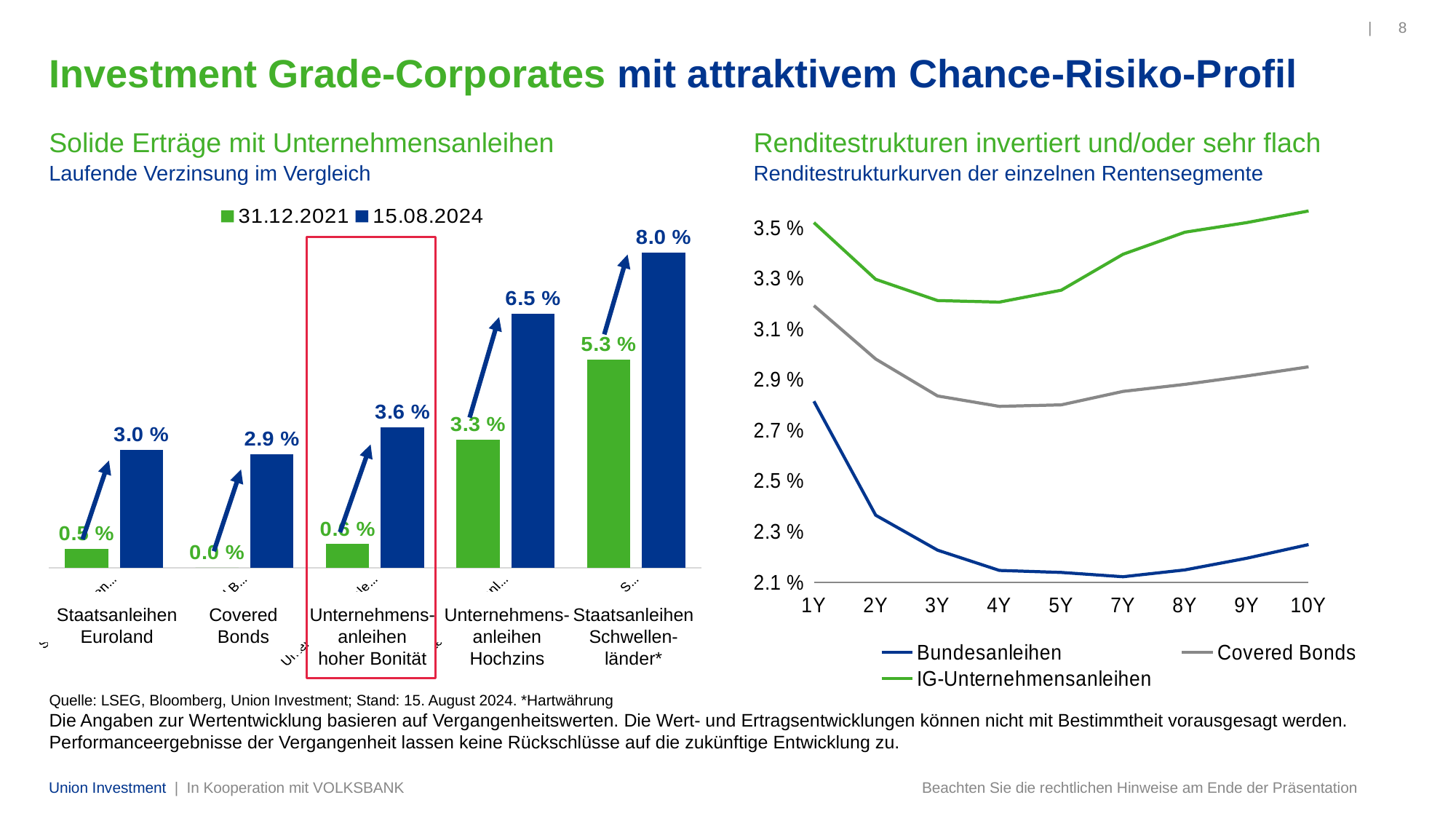
How many series does the legend of the right chart list? 3 In the left chart, what is the 15.08.2024 value for Unternehmensanleihen Hochzins? 6.5 % In the left chart, what is the difference between the 15.08.2024 and 31.12.2021 values for Unternehmensanleihen Hochzins? 3.2 % In the right chart, is the value for Bundesanleihen at 1Y greater or less than 2.7 %? greater In the left chart, what is the 15.08.2024 value for Staatsanleihen Schwellenländer? 8.0 % What kind of chart is the right chart, 'Renditestrukturen invertiert und/oder sehr flach'? line chart How many categories are shown in the left chart? 5 In the left chart, what is the 31.12.2021 value for Staatsanleihen Schwellenländer? 5.3 % What kind of chart is the left chart, 'Solide Erträge mit Unternehmensanleihen'? bar chart How many series does the legend of the left chart list? 2 In the left chart, which category has the highest 15.08.2024 value? Staatsanleihen Schwellenländer In the right chart, which series has the highest value at 10Y? IG-Unternehmensanleihen